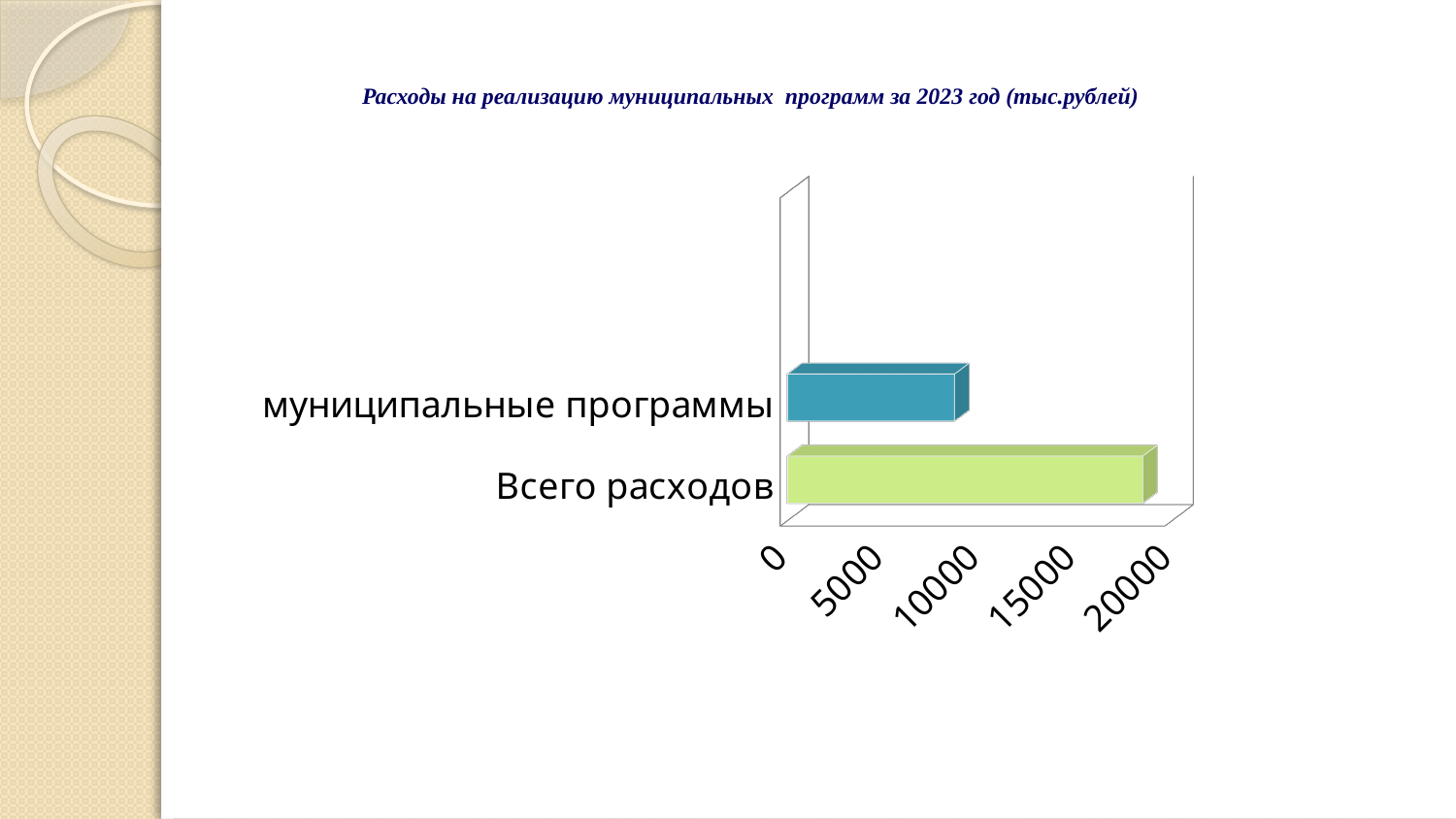
Is the value for Всего расходов greater or less than 15000? greater What is the title of the chart? Расходы на реализацию муниципальных программ за 2023 год (тыс.рублей) How many categories are plotted in the chart? 2 Is the value for муниципальные программы greater or less than 5000? greater Which is larger: the value for Всего расходов or the value for муниципальные программы? Всего расходов What kind of chart is shown on the slide? bar chart Is the value for Всего расходов greater or less than 20000? less Which category has the lowest value? муниципальные программы Which category has the highest value? Всего расходов What colour is the bar for Всего расходов? light green